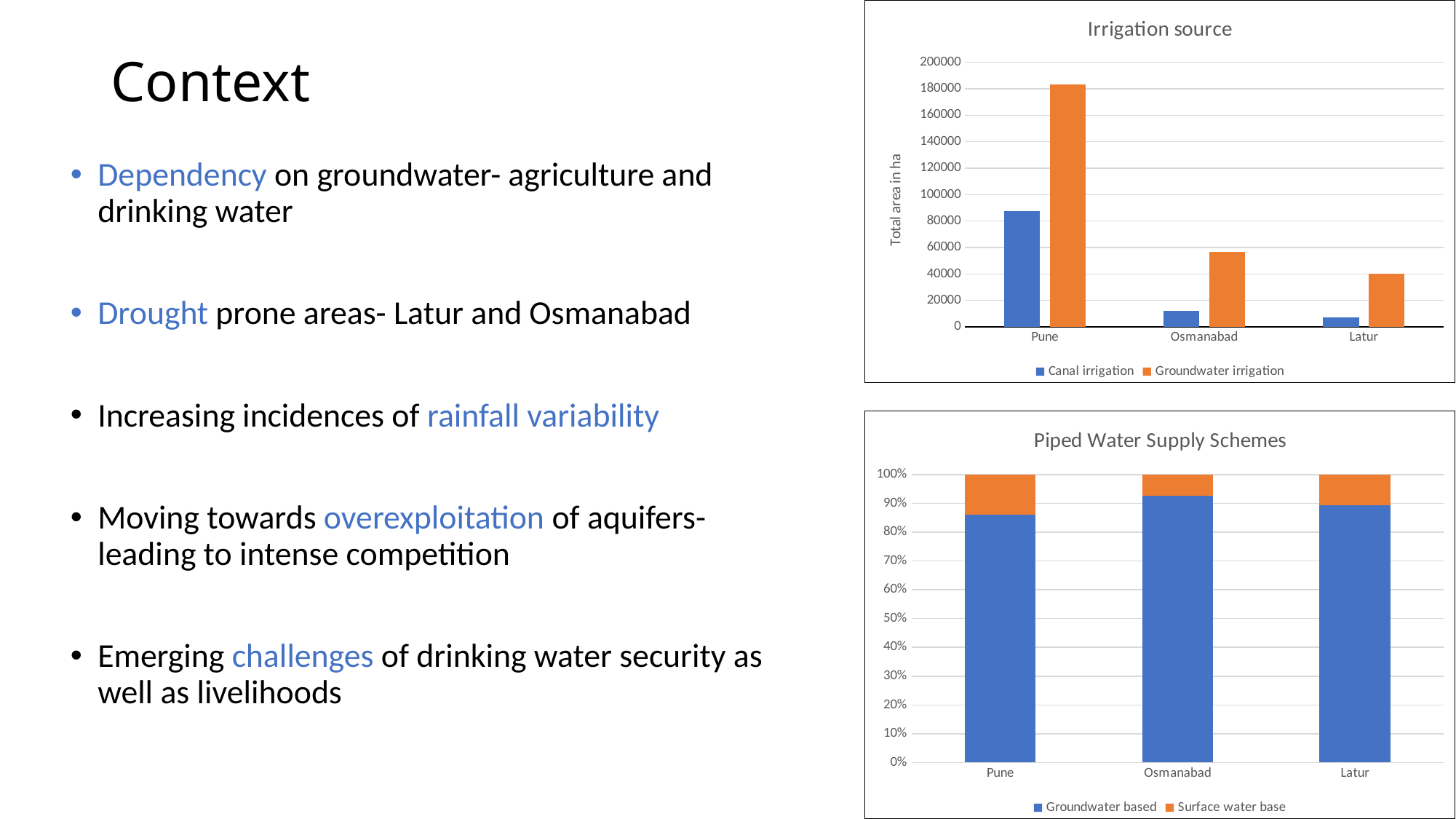
What kind of chart is the Piped Water Supply Schemes chart? Stacked bar chart In the Piped Water Supply Schemes chart, is the groundwater based share for Osmanabad greater or less than 90%? greater How many series does the legend of the Irrigation source chart list? 2 How many districts are shown in the Piped Water Supply Schemes chart? 3 In the Irrigation source chart, is the canal irrigation value for Osmanabad greater or less than 20000? less In the Piped Water Supply Schemes chart, which district has the largest surface water based share? Pune In the Irrigation source chart, is the groundwater irrigation value for Pune greater or less than 160000? greater In the Irrigation source chart, which district has the highest groundwater irrigation area? Pune In the Irrigation source chart, which is larger for Pune: canal irrigation or groundwater irrigation? Groundwater irrigation What is the y-axis label of the Irrigation source chart? Total area in ha In the Irrigation source chart, which district has the lowest canal irrigation area? Latur